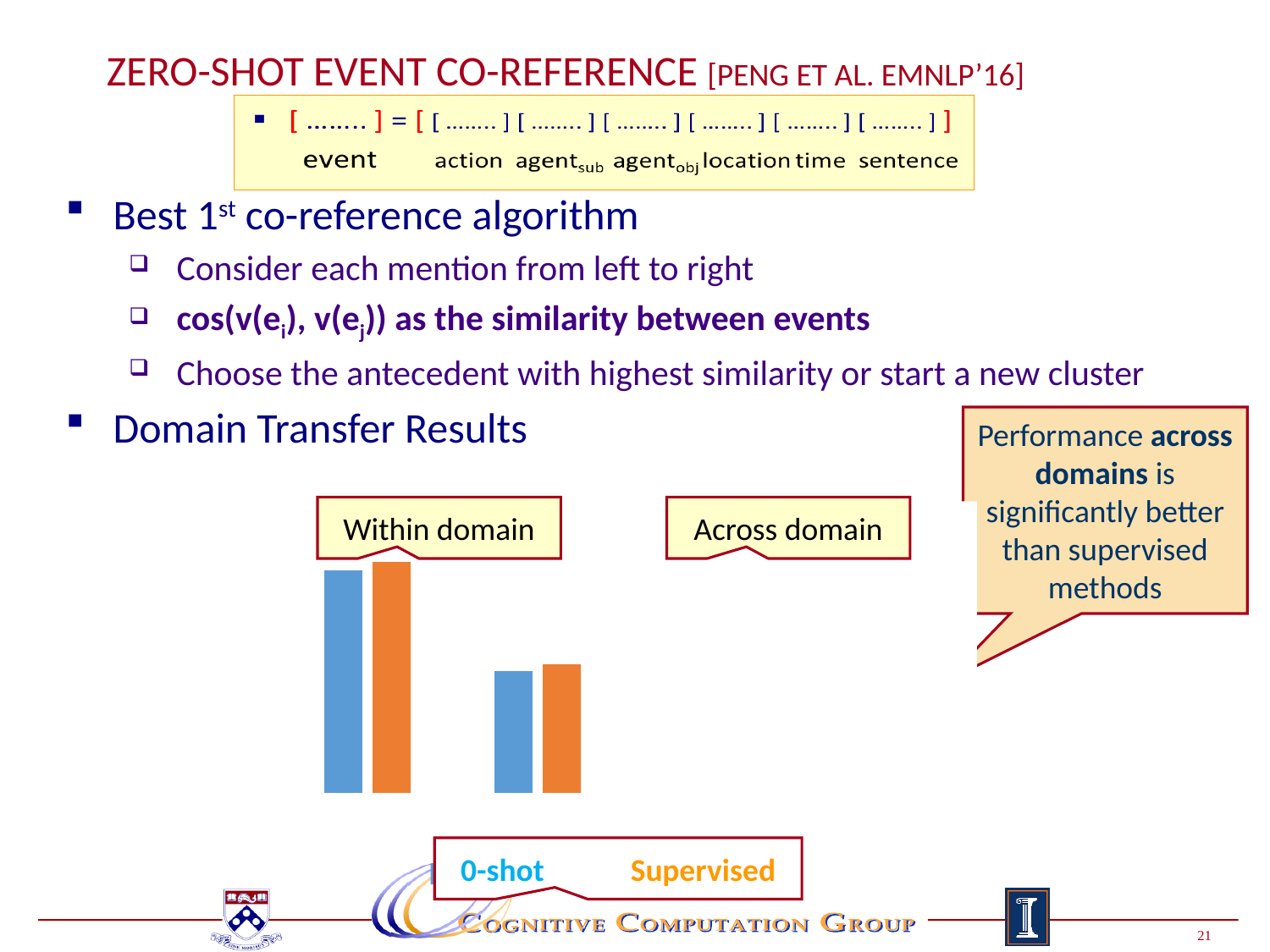
What are the two category groups in the Domain Transfer Results chart? Within domain and Across domain In the Domain Transfer Results chart, is the 0-shot bar taller for Within domain or Across domain? Within domain What kind of chart is shown under "Domain Transfer Results"? bar chart In the Domain Transfer Results chart, which category group has the tallest bars overall? Within domain How many category groups does the Domain Transfer Results bar chart show? 2 Do the bar heights in the Domain Transfer Results chart rise or fall going from Within domain to Across domain? fall How many series does the legend of the Domain Transfer Results chart list? 2 In the Domain Transfer Results chart, is the Supervised bar taller for Within domain or Across domain? Within domain In the Domain Transfer Results chart, which category group has the shortest bars overall? Across domain What are the two series named in the legend of the Domain Transfer Results chart? 0-shot and Supervised